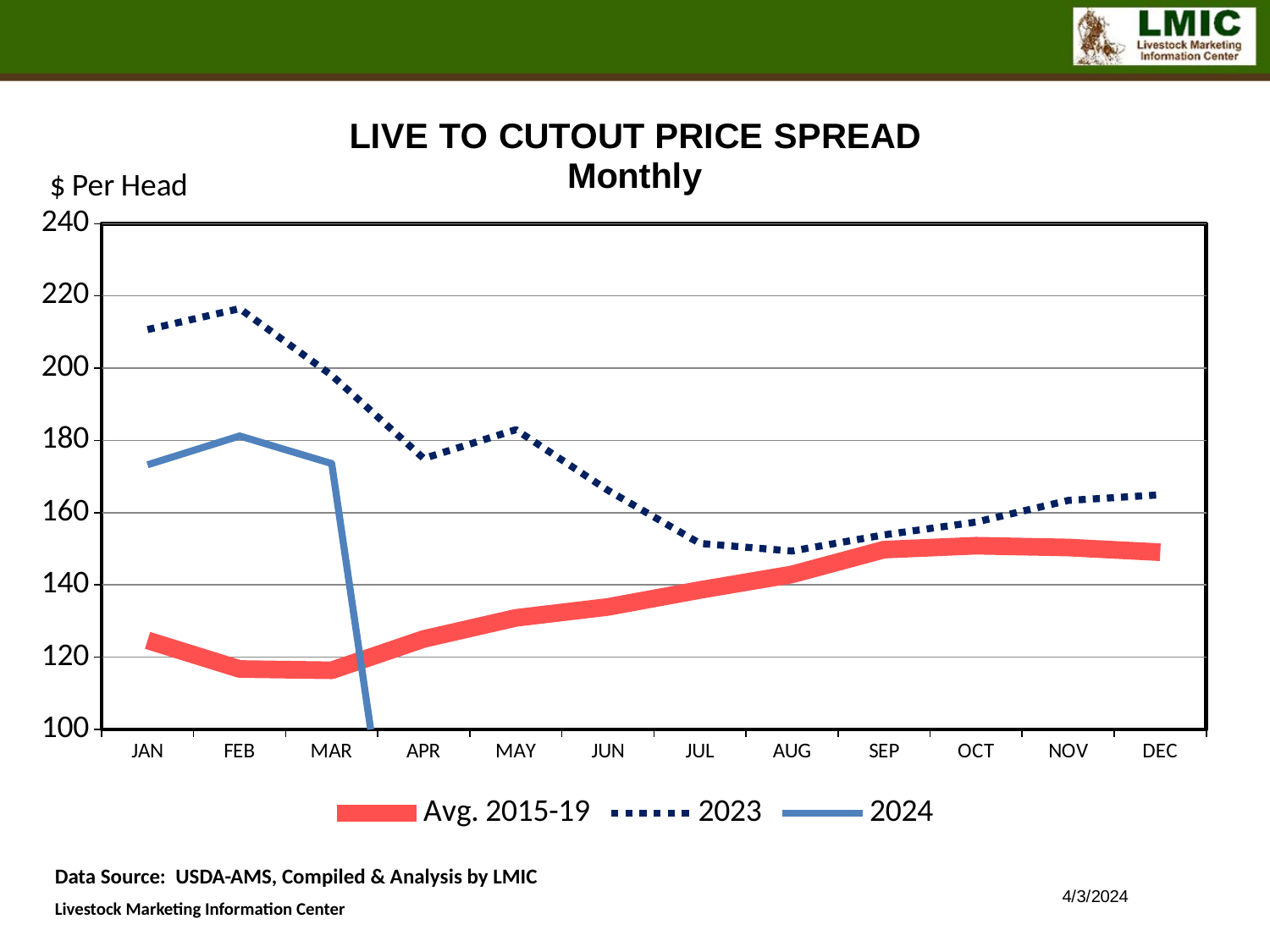
Which month has the highest value for the 2024 series? FEB Is the Avg. 2015-19 value for DEC greater or less than 140? greater Is the 2024 value for FEB greater or less than 160? greater How many months are shown along the x axis? 12 Is the 2023 value for JAN greater or less than 200? greater What kind of chart is shown on the slide? line chart Does the 2023 series rise or fall from FEB to AUG? fall Which month has the highest value for the 2023 series? FEB What is the label on the y axis? $ Per Head How many series does the legend list? 3 In JAN, which series has the larger value, 2023 or Avg. 2015-19? 2023